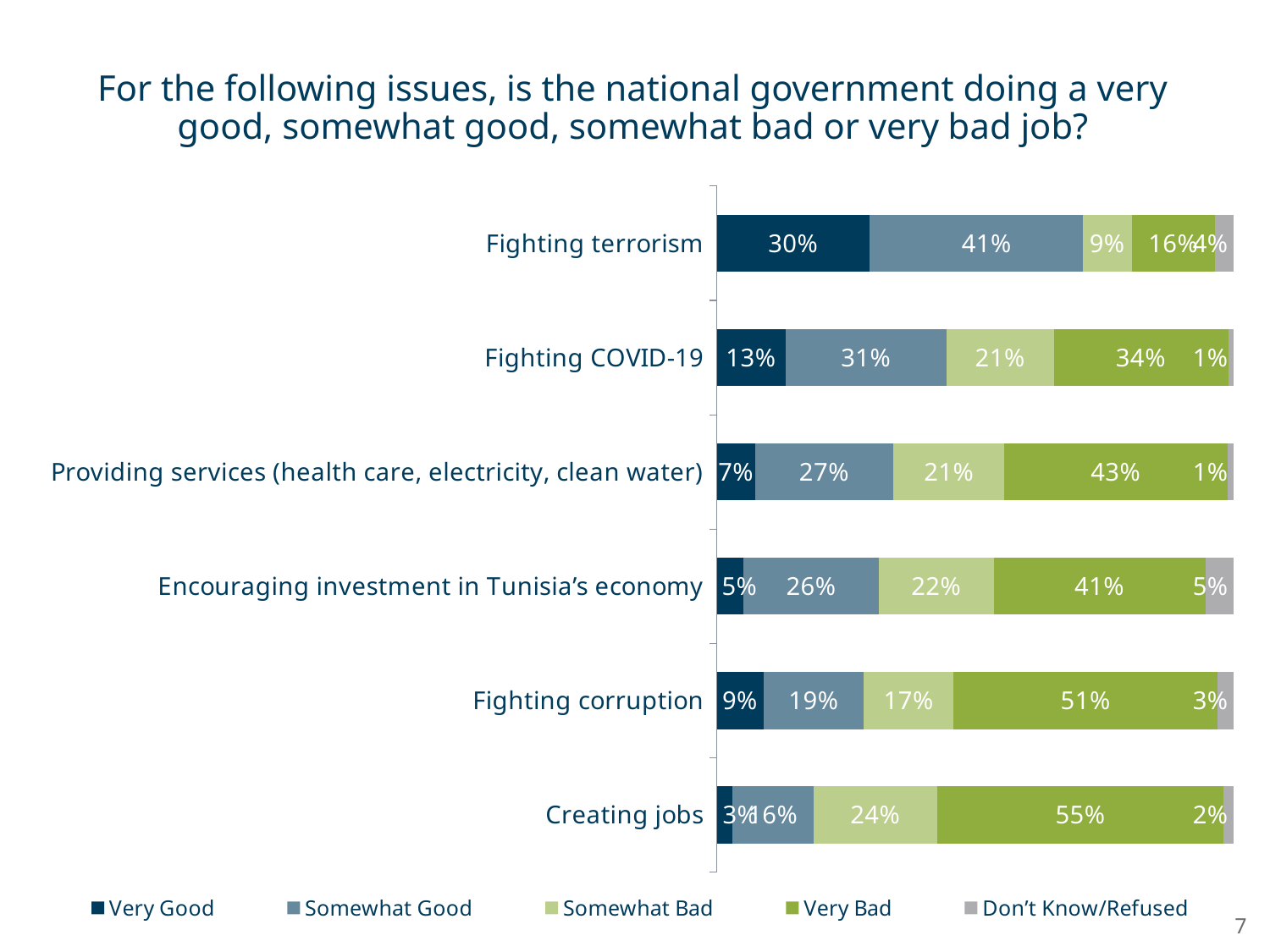
Which issue has the highest Very Good percentage? Fighting terrorism What kind of chart is shown on the slide? Stacked bar chart What percentage said the national government is doing a very good job fighting terrorism? 30% How many issues are shown in the chart? 6 What is the Very Bad value for Creating jobs? 55% Which has a larger Somewhat Bad value: Encouraging investment in Tunisia's economy or Fighting corruption? Encouraging investment in Tunisia's economy What is the Somewhat Good value for Fighting COVID-19? 31% Which issue has the highest Very Bad percentage? Creating jobs How many series does the legend list? 5 What is the Very Bad value for Providing services (health care, electricity, clean water)? 43% What is the difference between the Very Bad values for Fighting corruption and Fighting COVID-19? 17 percentage points What is the Don't Know/Refused value for Encouraging investment in Tunisia's economy? 5%